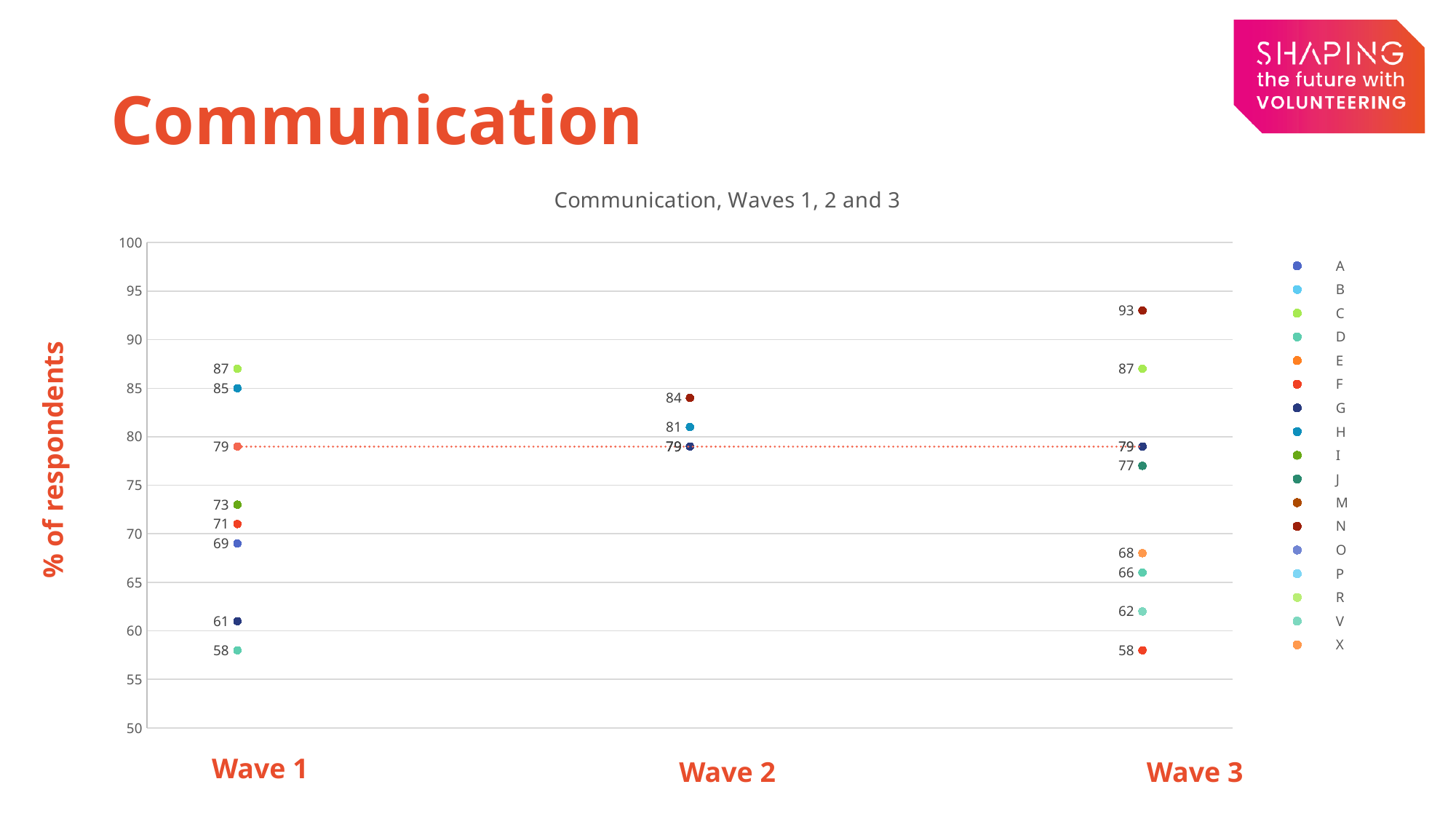
How many series does the legend list? 17 What kind of chart is shown on the slide? Scatter (dot) chart At what value does the horizontal dotted line run across the chart? 79 What is the lowest value plotted for Wave 1? 58 What is the highest value plotted for Wave 2? 84 What is the label on the vertical axis of the chart? % of respondents What is the lowest value plotted for Wave 2? 79 What is the difference between the highest value in Wave 3 and the highest value in Wave 1? 6 What is the title of the chart? Communication, Waves 1, 2 and 3 What is the highest value plotted for Wave 1? 87 What is the highest value plotted for Wave 3? 93